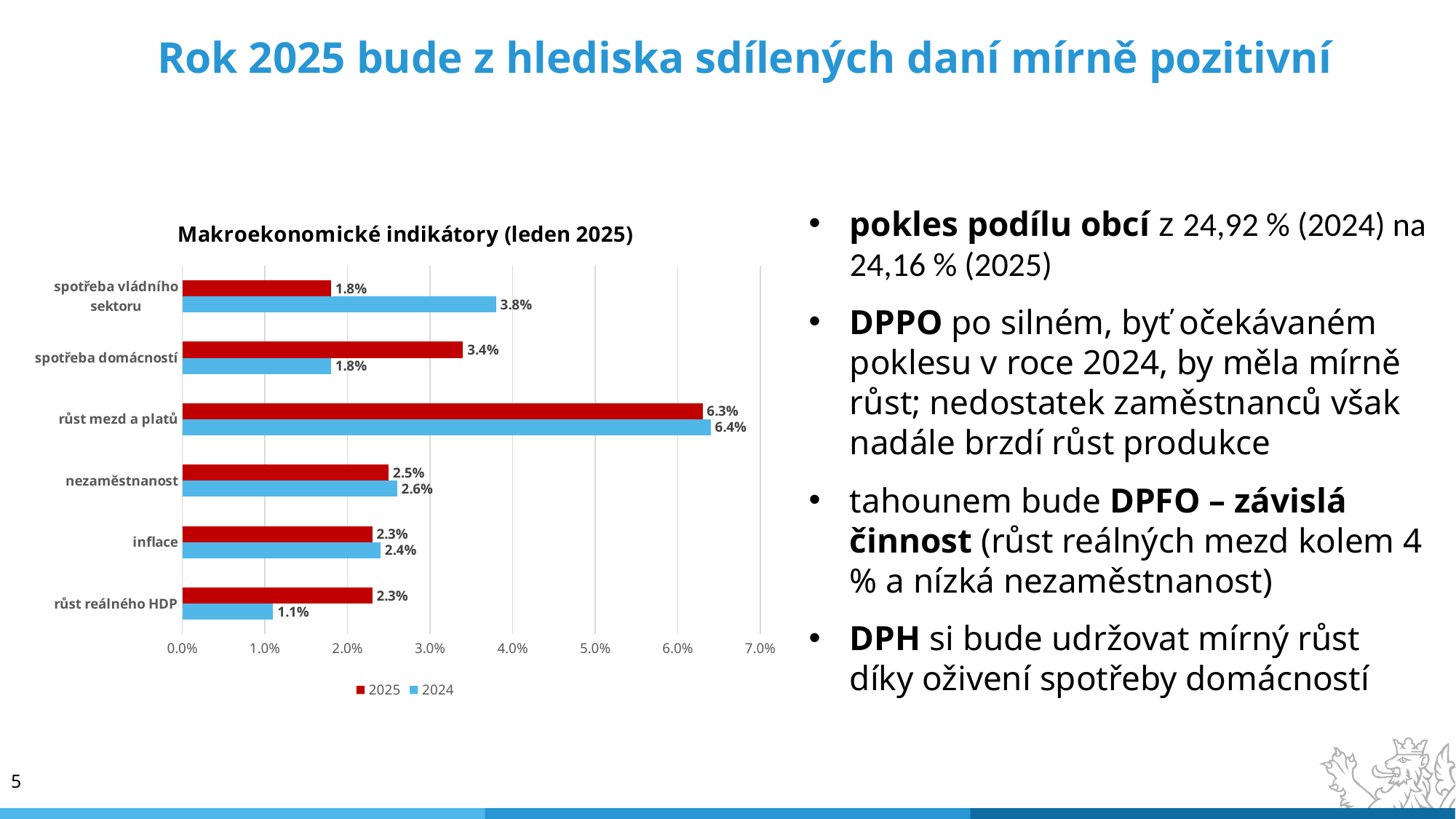
How many categories are shown on the chart? 6 Which category has the highest 2025 value? růst mezd a platů What is the title of the chart? Makroekonomické indikátory (leden 2025) How many series does the legend list? 2 What is the difference between the 2024 and 2025 values for spotřeba vládního sektoru? 2.0% Is the 2025 value for nezaměstnanost greater or less than 2.0%? greater What kind of chart is shown on the slide? bar chart What is the 2024 value for spotřeba vládního sektoru? 3.8% Which is larger for spotřeba domácností, the 2025 value or the 2024 value? 2025 What is the 2024 value for růst reálného HDP? 1.1% Which category has the lowest 2024 value? růst reálného HDP What is the 2025 value for růst mezd a platů? 6.3%